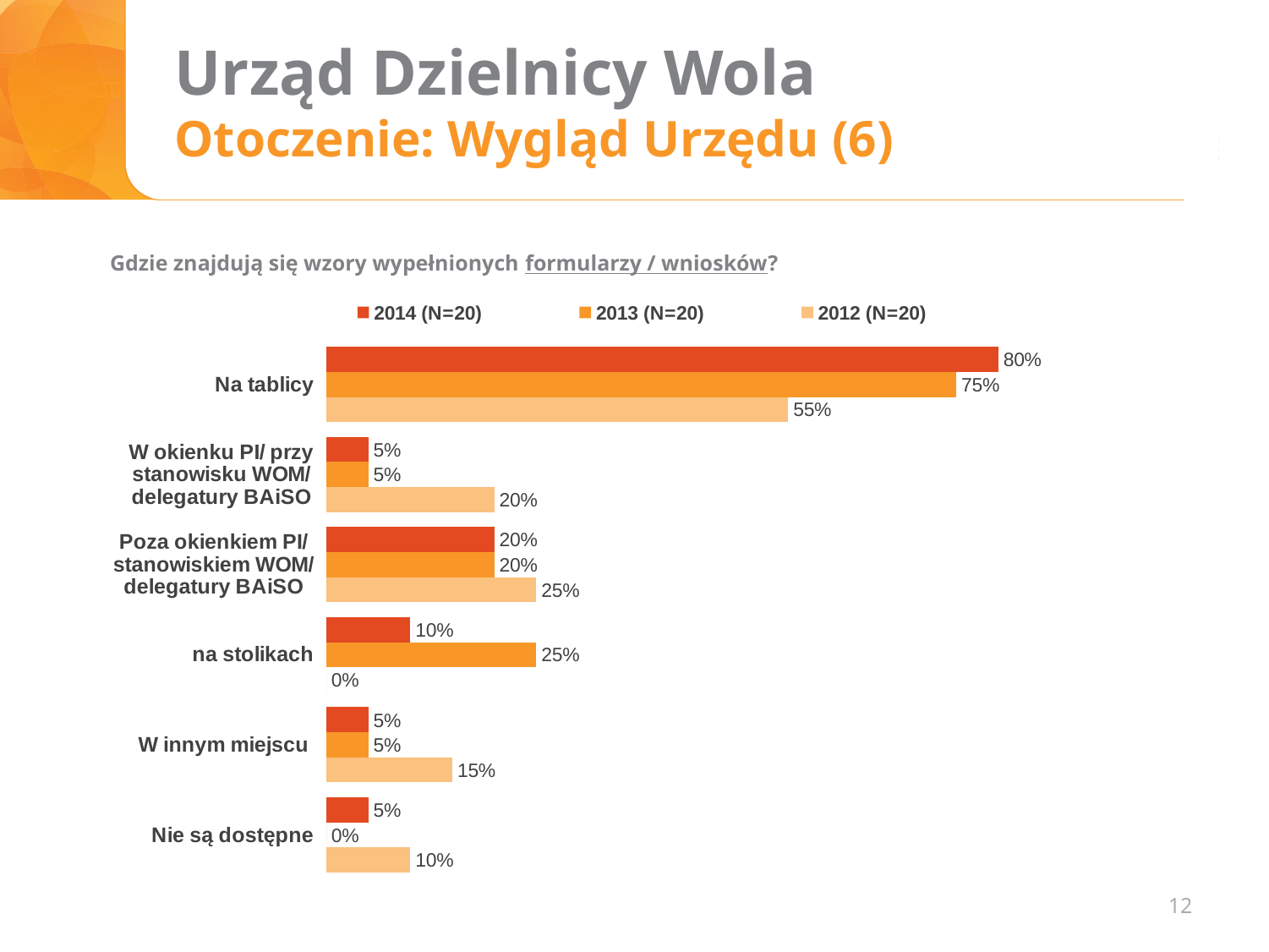
What is the value for "Na tablicy" in the 2014 (N=20) series? 80% What kind of chart is shown on the slide? Bar chart How many categories are shown on the chart? 6 What is the difference between the 2014 (N=20) and 2012 (N=20) values for "Na tablicy"? 25% What is the value for "na stolikach" in the 2013 (N=20) series? 25% What is the value for "Nie są dostępne" in the 2013 (N=20) series? 0% What question is the chart answering, as written above it? Gdzie znajdują się wzory wypełnionych formularzy / wniosków? What is the value for "W innym miejscu" in the 2012 (N=20) series? 15% Which category has the highest value in the 2012 (N=20) series? Na tablicy How many series does the legend list? 3 Which is larger for "na stolikach": the 2014 (N=20) value or the 2013 (N=20) value? 2013 (N=20) Which category has the lowest value in the 2012 (N=20) series? na stolikach